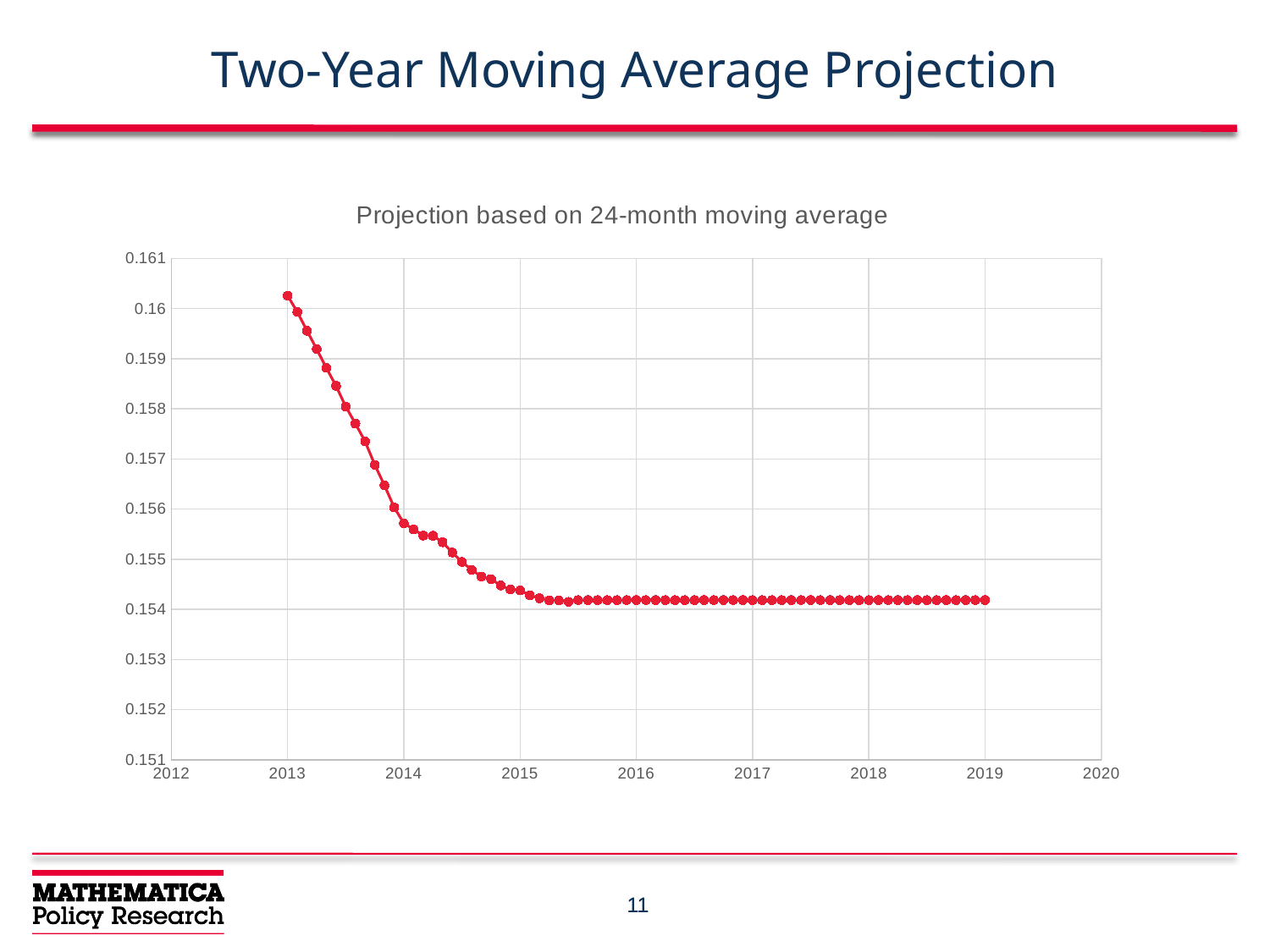
What colour are the plotted points and line? red Is the value at the start of 2017 greater or less than 0.155? less Is the value at the start of 2019 greater or less than 0.153? greater Is the value at the start of 2014 greater or less than 0.155? greater What kind of chart is shown on the slide? line chart Which is larger, the value at the start of 2014 or the value at the start of 2016? 2014 What is the title printed above the chart? Projection based on 24-month moving average At which year on the x axis does the series reach its highest value? 2013 How do the values change along the x axis from 2013 to 2019? They fall until about 2015, then stay flat Which is larger, the value at the start of 2013 or the value at the start of 2019? 2013